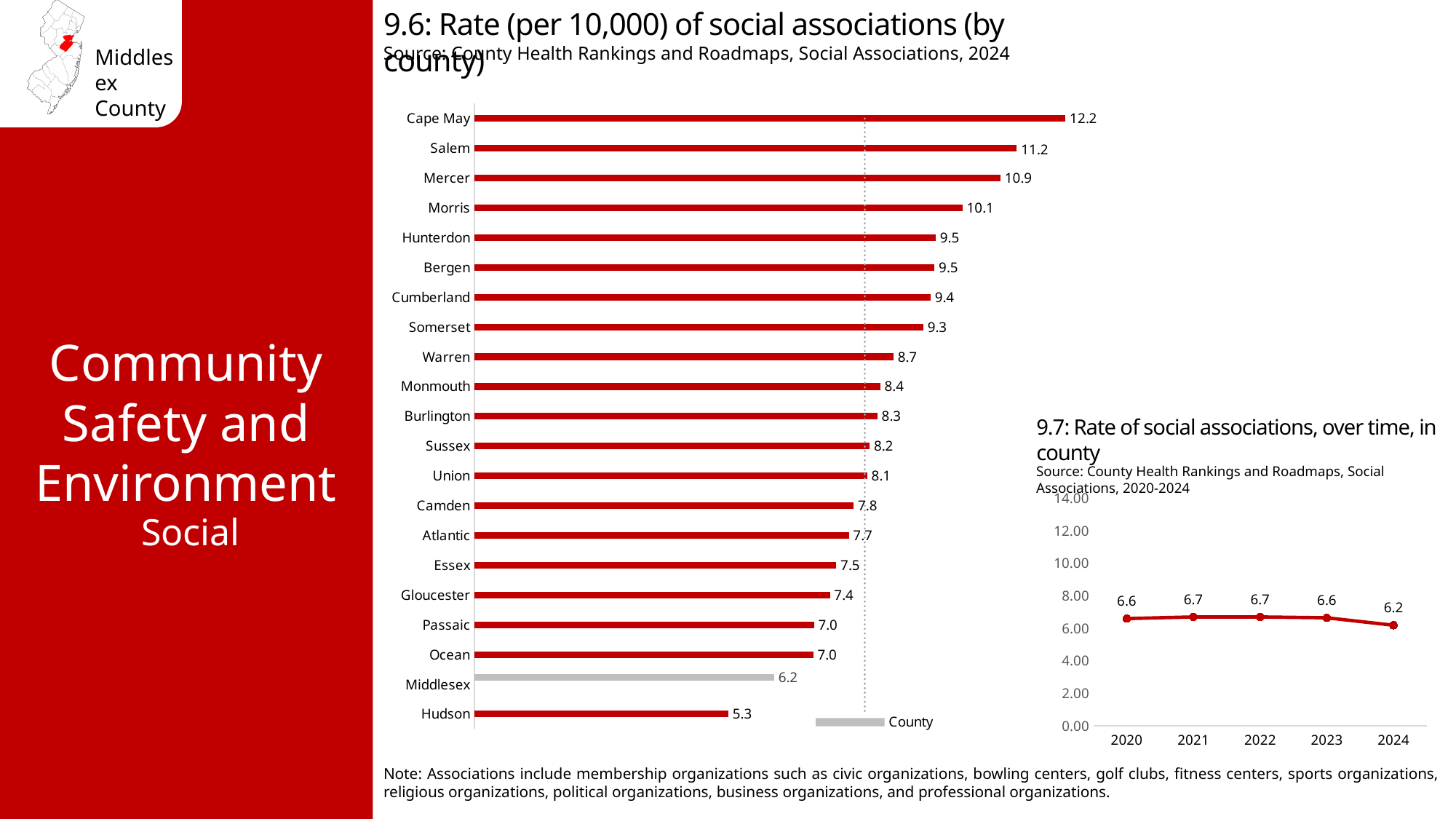
What kind of chart is '9.7: Rate of social associations, over time, in county'? Line chart In the chart '9.6: Rate (per 10,000) of social associations (by county)', what is the value for Middlesex? 6.2 What kind of chart is '9.6: Rate (per 10,000) of social associations (by county)'? Bar chart In the chart '9.6: Rate (per 10,000) of social associations (by county)', which county has the lowest rate? Hudson In the chart '9.7: Rate of social associations, over time, in county', is the value for 2024 greater or less than 8.00? less How many counties are shown in the chart '9.6: Rate (per 10,000) of social associations (by county)'? 21 In the chart '9.6: Rate (per 10,000) of social associations (by county)', which has a higher value, Mercer or Morris? Mercer In the chart '9.6: Rate (per 10,000) of social associations (by county)', what is the value for Gloucester? 7.4 In the chart '9.7: Rate of social associations, over time, in county', what is the difference between the values for 2023 and 2024? 0.4 In the chart '9.7: Rate of social associations, over time, in county', what is the value for 2022? 6.7 In the chart '9.6: Rate (per 10,000) of social associations (by county)', which county has the highest rate? Cape May In the chart '9.6: Rate (per 10,000) of social associations (by county)', what is the difference between the values for Cape May and Hudson? 6.9